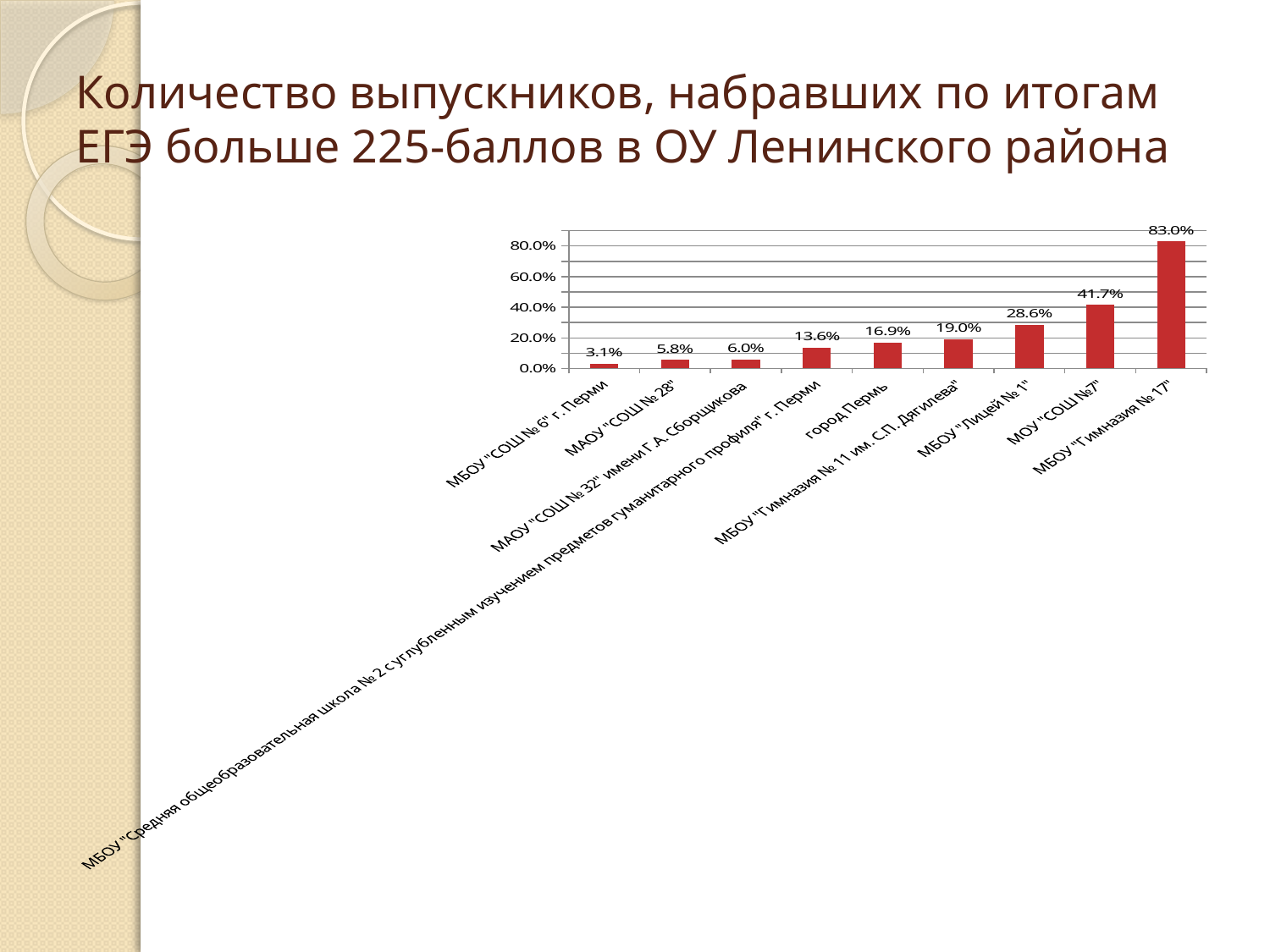
Which category has the highest value? МБОУ "Гимназия № 17" What is the value for МБОУ "Гимназия № 17"? 83.0% Do the values rise or fall from left to right along the x axis? rise Which is larger, the value for МБОУ "Гимназия № 11 им. С.П. Дягилева" or the value for город Пермь? МБОУ "Гимназия № 11 им. С.П. Дягилева" How many categories are shown on the chart? 9 Is the value for МОУ "СОШ №7" greater or less than 40.0%? greater What is the value for МАОУ "СОШ № 28"? 5.8% What is the difference between the values for МБОУ "Гимназия № 17" and МОУ "СОШ №7"? 41.3% What kind of chart is shown on the slide? bar chart What is the value for город Пермь? 16.9% Which category has the lowest value? МБОУ "СОШ № 6" г. Перми What is the value for МБОУ "Лицей № 1"? 28.6%